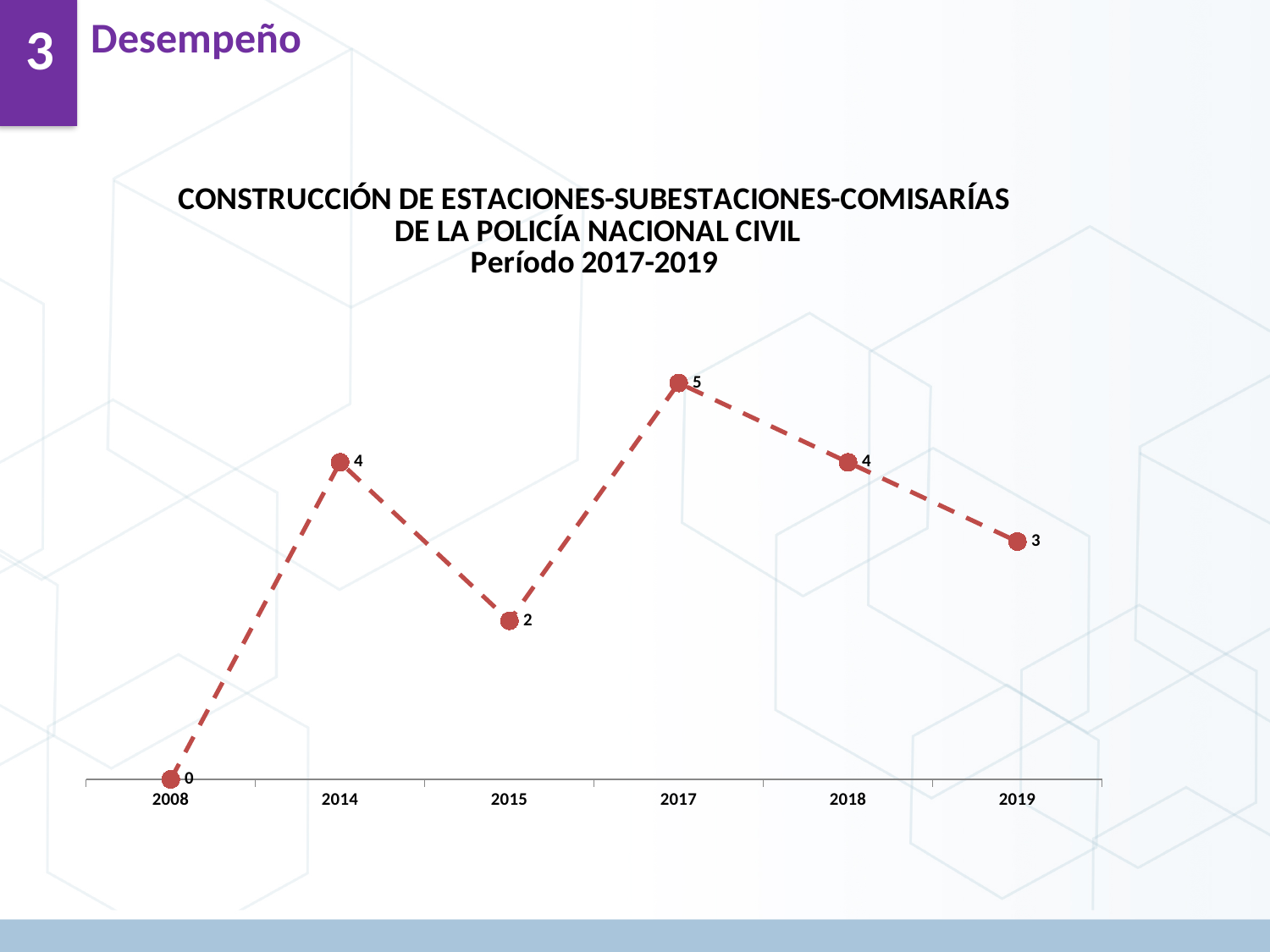
What kind of chart is this? line chart What value is shown for 2015? 2 What value is shown for 2008? 0 How many years are plotted on the x axis? 6 What is the difference between the values for 2017 and 2015? 3 What value is shown for 2019? 3 What is the difference between the values for 2018 and 2019? 1 Which year has the lowest value? 2008 Do the values rise or fall from 2017 to 2019? fall Which is larger, the value for 2014 or the value for 2015? 2014 Which year has the highest value? 2017 What value is shown for 2017? 5